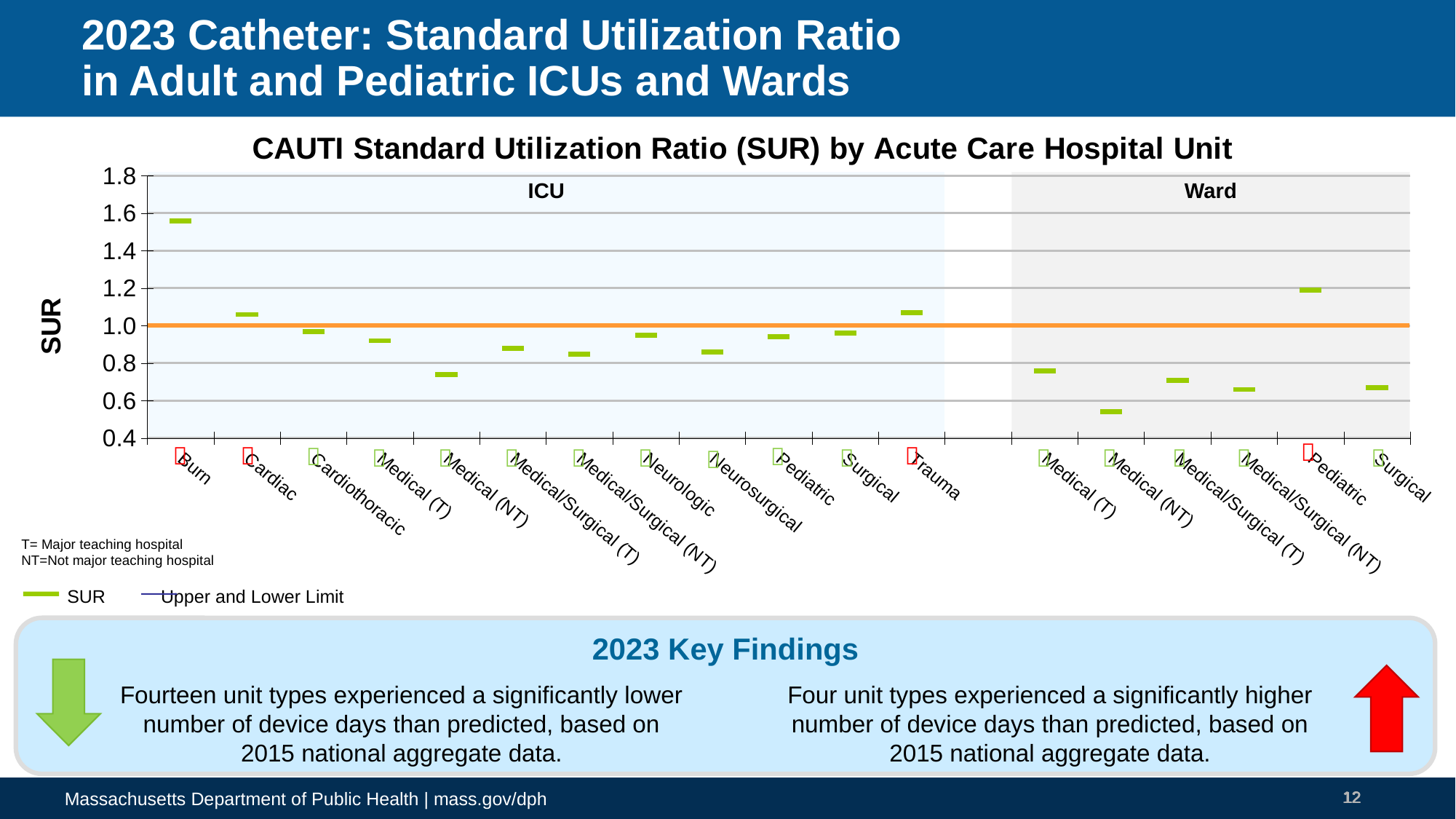
How many entries does the chart legend list? 2 How many unit types are plotted in the ICU group? 12 What is the title of the chart? CAUTI Standard Utilization Ratio (SUR) by Acute Care Hospital Unit Is the SUR for the ICU Trauma unit greater or less than 1.0? greater Which unit has the highest SUR on the chart? Burn (ICU) Which has the larger SUR, the Ward Pediatric unit or the Ward Surgical unit? Ward Pediatric Is the SUR for the Ward Pediatric unit greater or less than 1.0? greater Is the SUR for the Ward Medical (NT) unit greater or less than 0.6? less Which unit has the lowest SUR on the chart? Medical (NT) in the Ward group Which has the larger SUR, the Burn ICU or the Cardiac ICU? Burn ICU